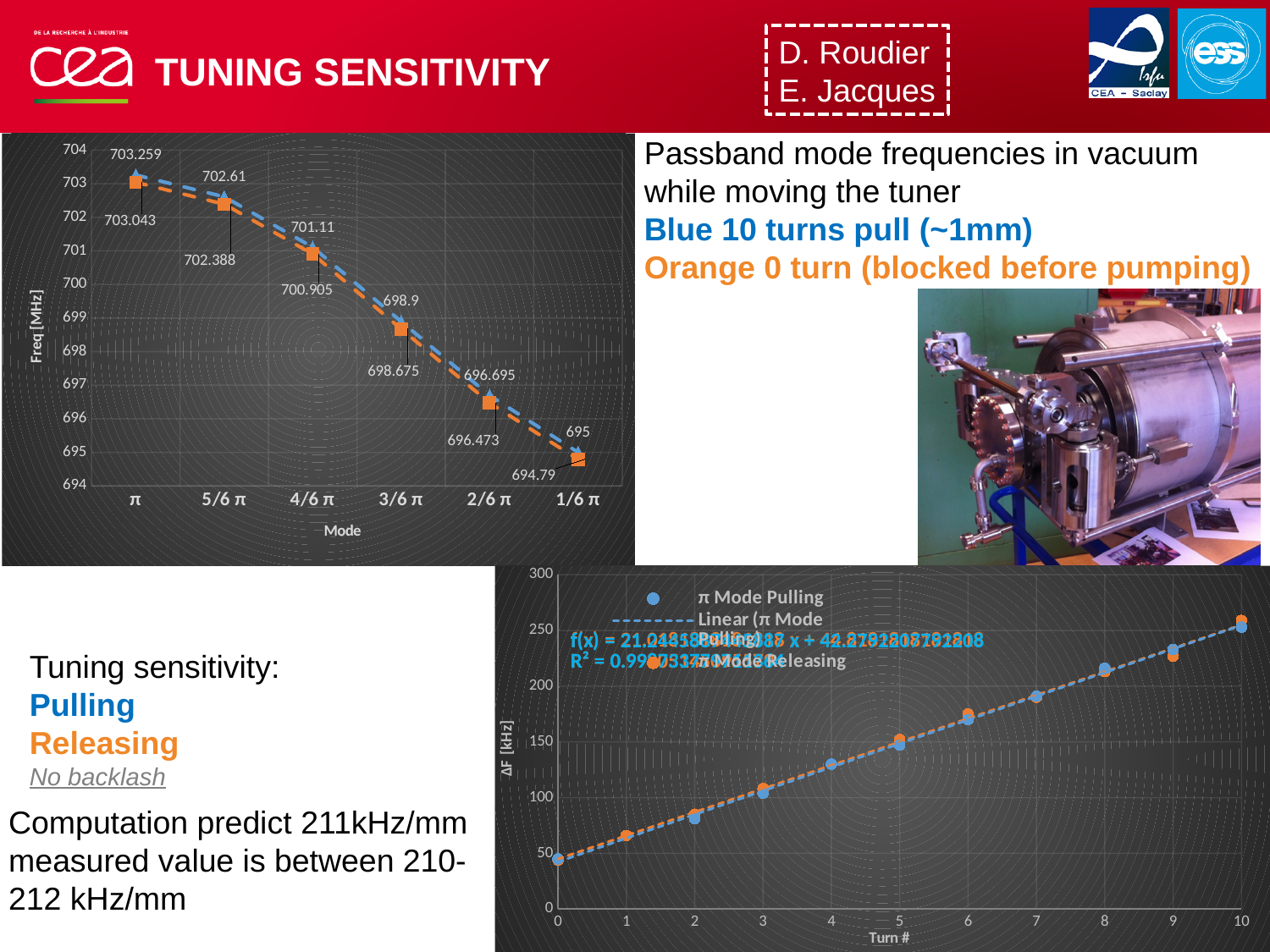
In the top-left chart of frequency versus mode, what is the blue series value at the 4/6 π mode? 701.11 In the bottom-right chart of ΔF versus Turn #, is the value at turn 10 greater or less than 250? greater In the bottom-right chart of ΔF versus Turn #, do the values rise or fall as the turn number increases? rise In the top-left chart of frequency versus mode, how many modes are shown on the x axis? 6 In the top-left chart of frequency versus mode, what is the difference between the blue and orange values at the 2/6 π mode? 0.222 In the top-left chart of frequency versus mode, what is the label of the y axis? Freq [MHz] In the top-left chart of frequency versus mode, what is the orange series value at the 3/6 π mode? 698.675 In the top-left chart of frequency versus mode, which mode has the lowest frequency for the blue series? 1/6 π In the top-left chart of frequency versus mode, what is the blue series value at the π mode? 703.259 In the bottom-right chart of ΔF versus Turn #, is the value at turn 0 greater or less than 50? less In the top-left chart of frequency versus mode, what is the orange series value at the 1/6 π mode? 694.79 In the top-left chart of frequency versus mode, do the frequencies rise or fall from π to 1/6 π along the x axis? fall